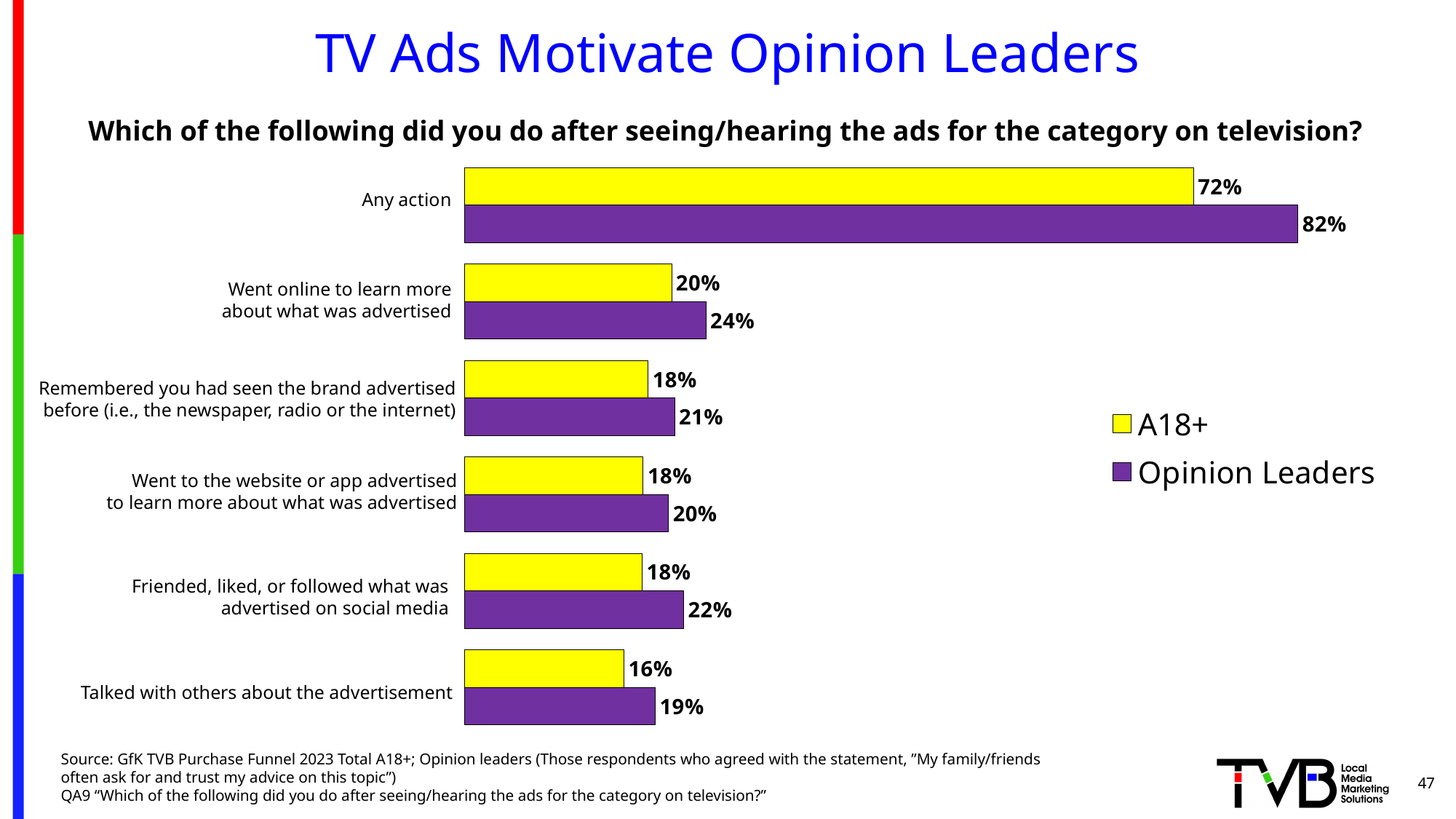
Which colour represents Opinion Leaders in the chart? Purple What percentage of Opinion Leaders took any action after seeing/hearing the ads? 82% What type of chart is shown on the slide? Bar chart Which category has the lowest value for A18+? Talked with others about the advertisement What is the Opinion Leaders value for 'Talked with others about the advertisement'? 19% How many series does the legend list? 2 For 'Went online to learn more about what was advertised', which group has the larger value, A18+ or Opinion Leaders? Opinion Leaders Which category has the highest value for Opinion Leaders? Any action What percentage of A18+ went online to learn more about what was advertised? 20% What is the difference between the Opinion Leaders and A18+ values for 'Any action'? 10 percentage points What is the A18+ value for 'Friended, liked, or followed what was advertised on social media'? 18% How many categories are shown in the chart? 6